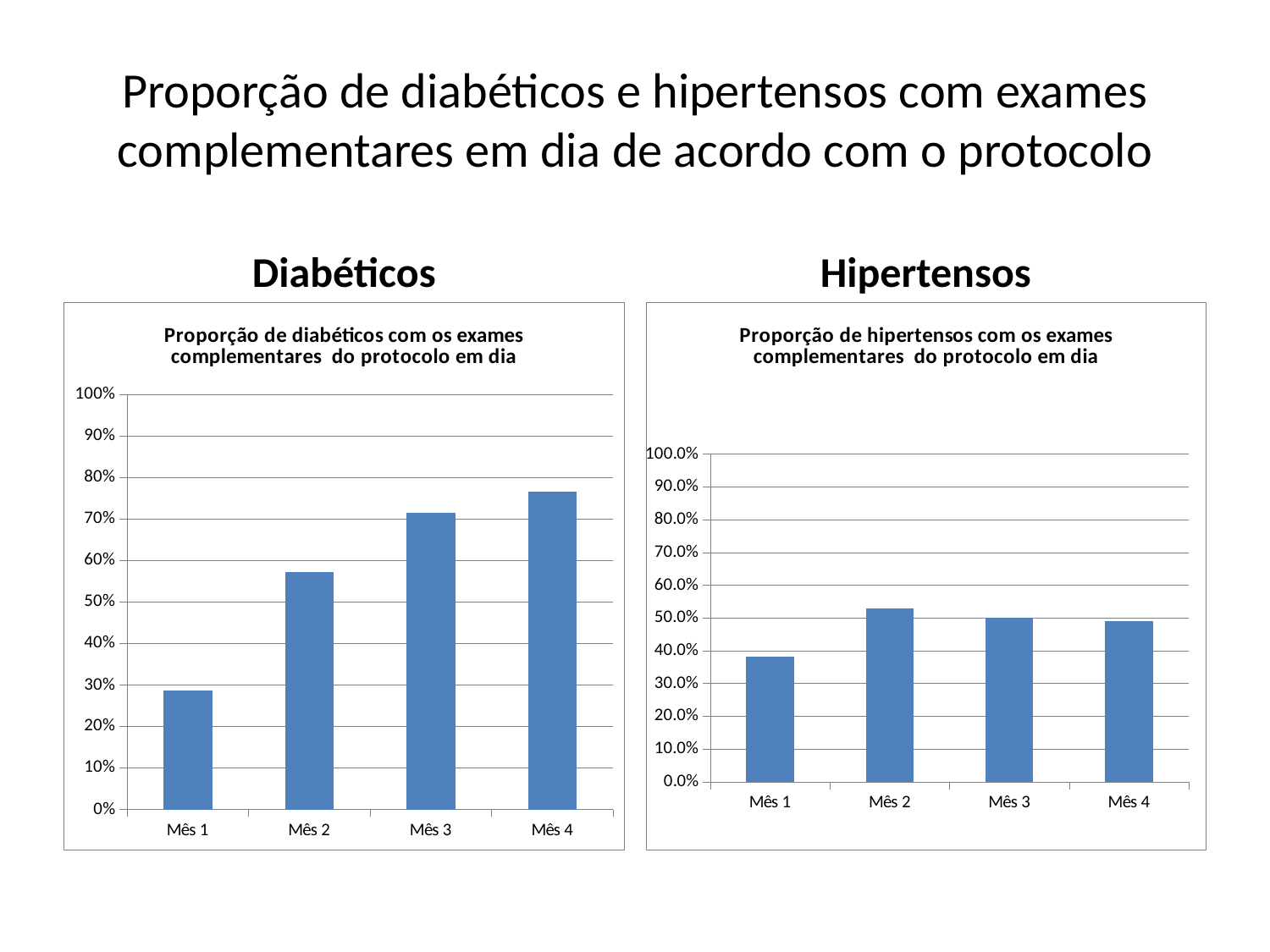
In the Diabéticos chart on the left, do the values rise or fall from Mês 1 to Mês 4? rise In the Hipertensos chart on the right, is the value for Mês 1 greater or less than 40.0%? less In the Diabéticos chart on the left, is the value for Mês 1 greater or less than 30%? less How many months are shown on the x axis of the Hipertensos chart on the right? 4 In the Diabéticos chart on the left, is the value for Mês 4 greater or less than 70%? greater In the Diabéticos chart on the left, which is larger, the value for Mês 2 or the value for Mês 3? Mês 3 In the Hipertensos chart on the right, which month has the highest proportion? Mês 2 In the Diabéticos chart on the left, which month has the lowest proportion? Mês 1 What kind of chart is the Diabéticos chart on the left? bar chart In the Hipertensos chart on the right, which month has the lowest proportion? Mês 1 In the Diabéticos chart on the left, which month has the highest proportion? Mês 4